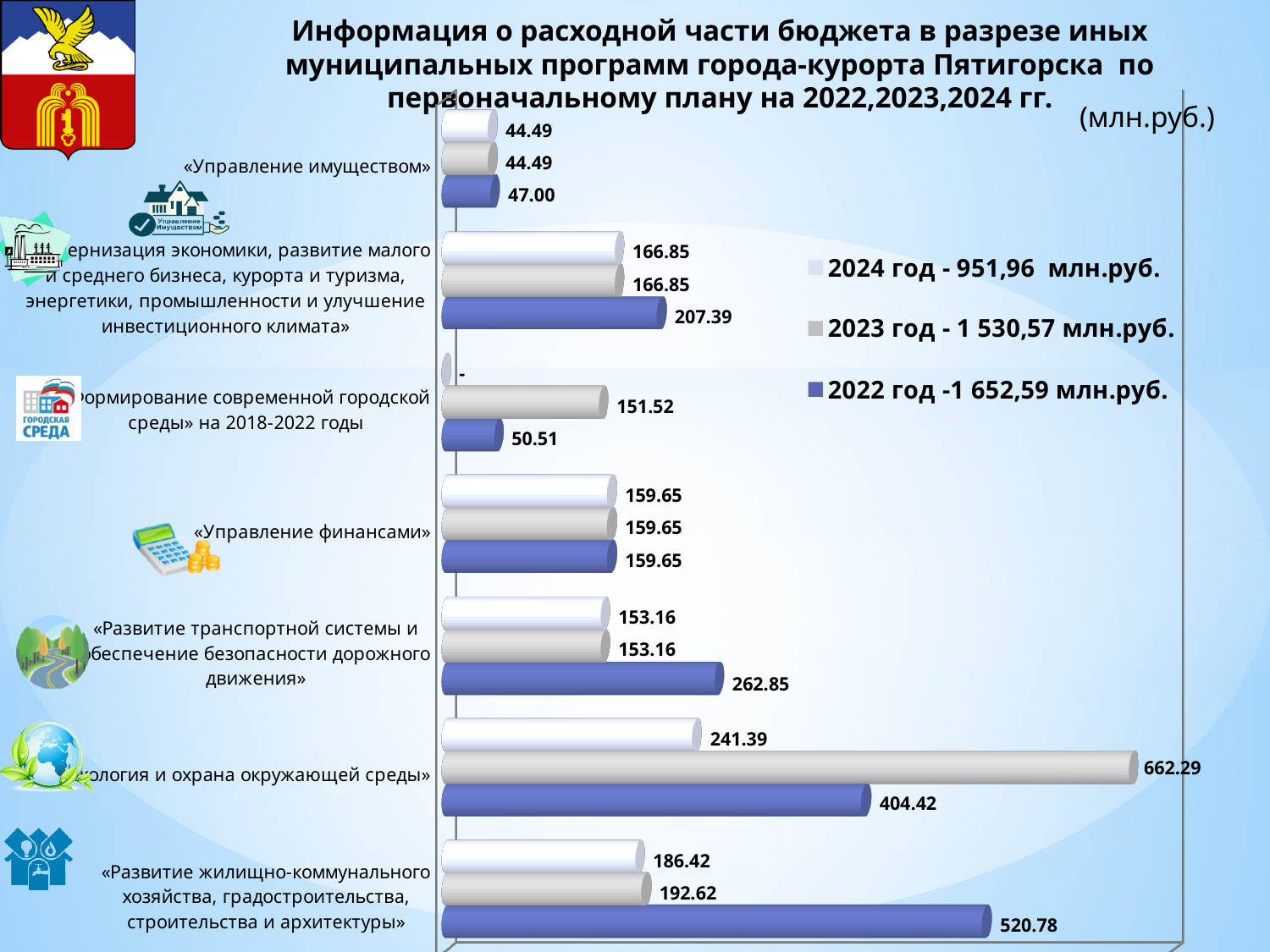
What is the difference between the 2022 and 2024 values for «Развитие транспортной системы и обеспечение безопасности дорожного движения»? 109.69 What is the 2022 value for «Развитие транспортной системы и обеспечение безопасности дорожного движения»? 262.85 According to the legend, what is the total for 2023 год? 1 530,57 млн.руб. How many program categories are shown on the chart? 7 Which category has the lowest 2024 value among those with a printed value? «Управление имуществом» Which category has the highest 2022 value? «Развитие жилищно-коммунального хозяйства, градостроительства, строительства и архитектуры» What type of chart is shown on the slide? bar chart What is the 2024 value for «Развитие жилищно-коммунального хозяйства, градостроительства, строительства и архитектуры»? 186.42 What is the 2022 value for «Управление имуществом»? 47.00 What is the 2023 value for «Формирование современной городской среды» на 2018-2022 годы? 151.52 How many series does the legend list? 3 Which is larger for «Управление финансами»: the 2022 value or the 2023 value? They are equal (159.65)